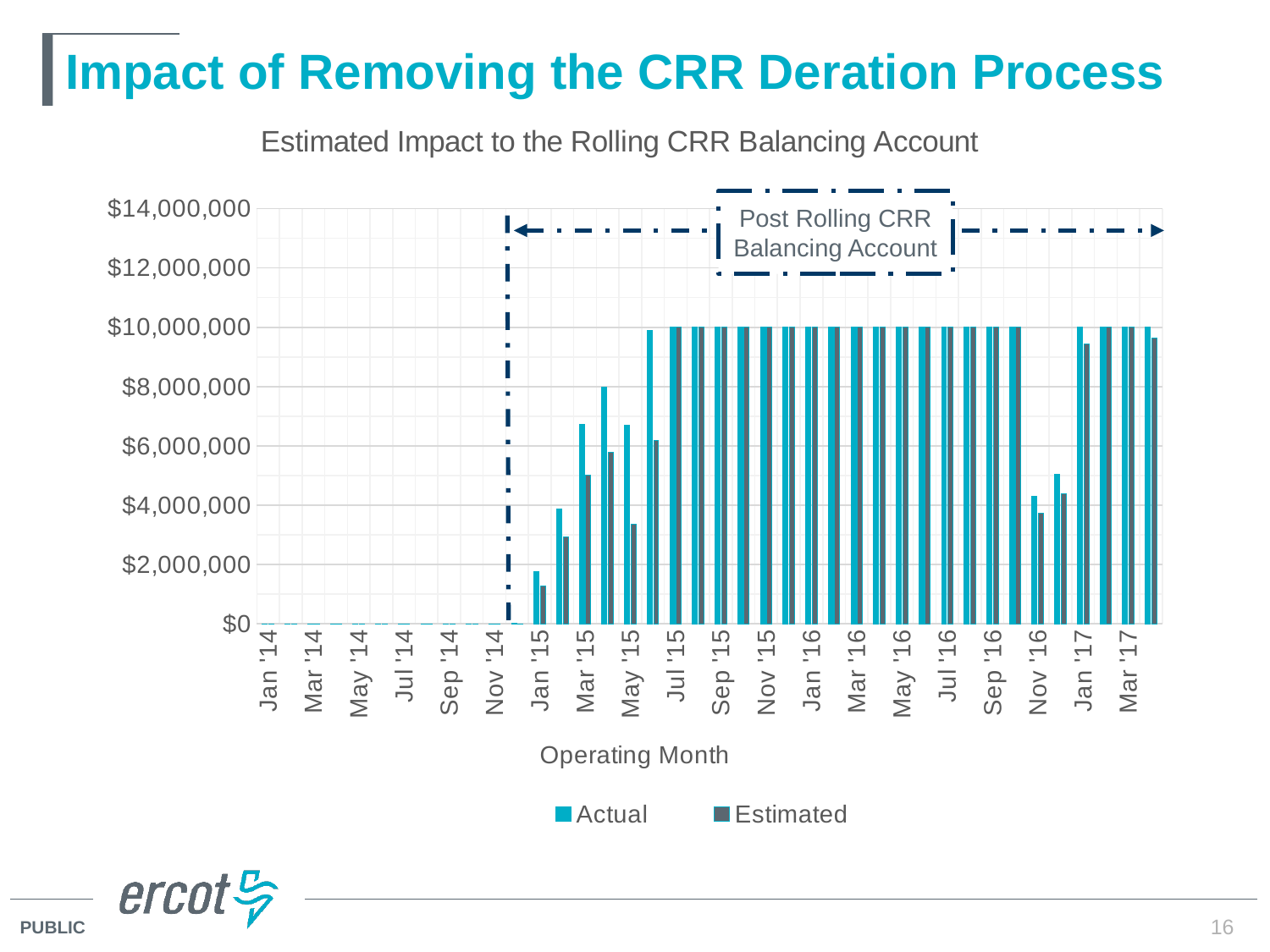
What kind of chart is shown on the slide? bar chart Is the Actual value for Mar '15 greater or less than $6,000,000? greater For Nov '16, which is larger, the Actual value or the Estimated value? Actual Is the Estimated value for Mar '15 greater or less than $6,000,000? less How many series does the legend list? 2 For Mar '15, which is larger, the Actual value or the Estimated value? Actual Is the Actual value for Jul '15 greater or less than $8,000,000? greater Do the Actual values rise or fall from Jan '15 to Jul '15? rise What is the title of the chart? Estimated Impact to the Rolling CRR Balancing Account What is the x-axis title of the chart? Operating Month